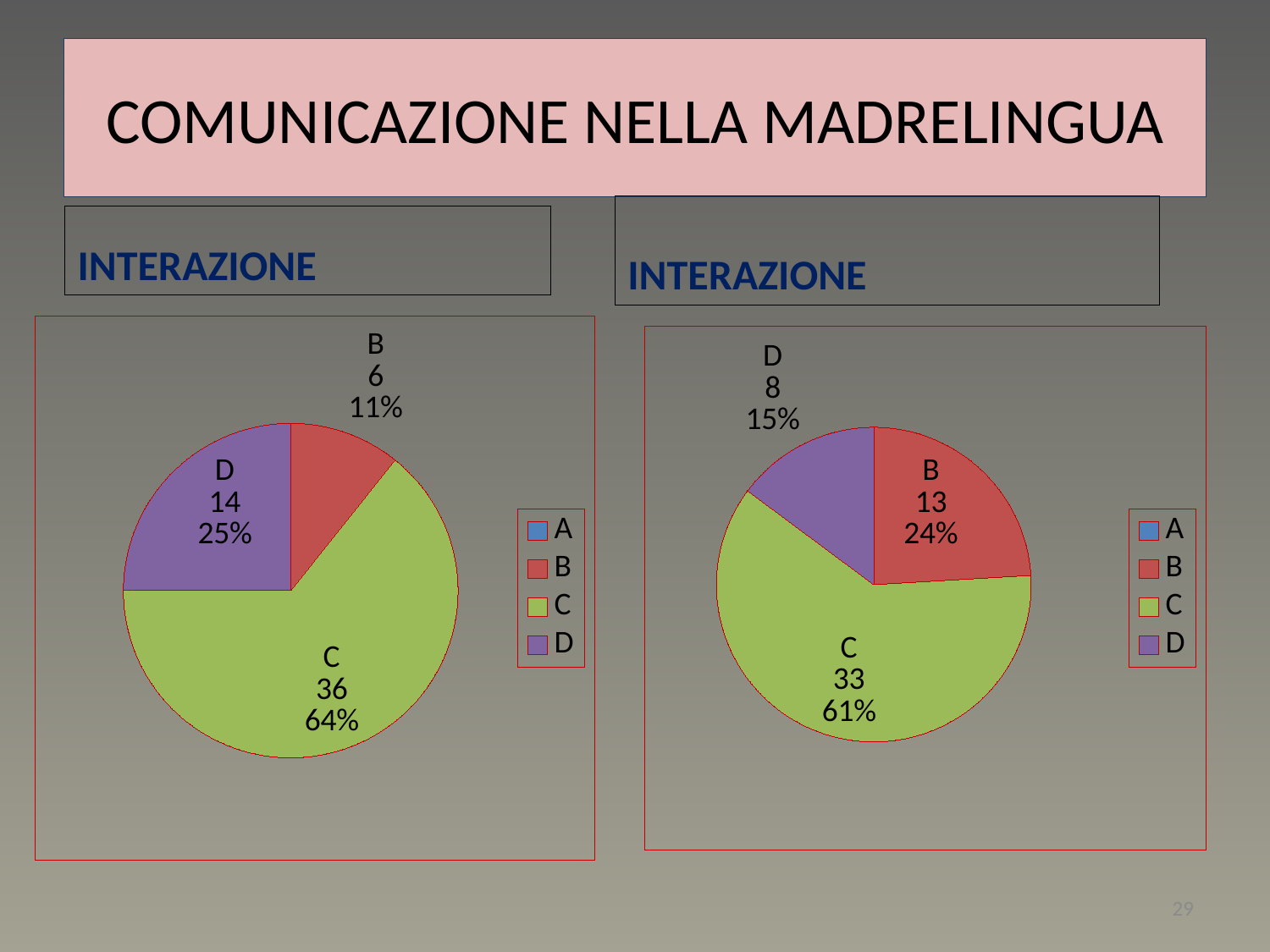
In the right pie chart, which labelled category has the largest slice? C What colour represents category C in the right pie chart? green How many entries does the legend of the left pie chart list? 4 In the right pie chart, what is the difference between the values for B and D? 5 In the right pie chart, what percentage share does category C have? 61% In the left pie chart, what percentage share does category D have? 25% In the left pie chart, what value is shown for category C? 36 In the right pie chart, which is larger, the value for B or the value for D? B What type of chart is shown on the left side of the slide? pie chart In the left pie chart, what is the difference between the values for C and D? 22 In the right pie chart, what value is shown for category B? 13 In the left pie chart, which labelled category has the smallest slice? B